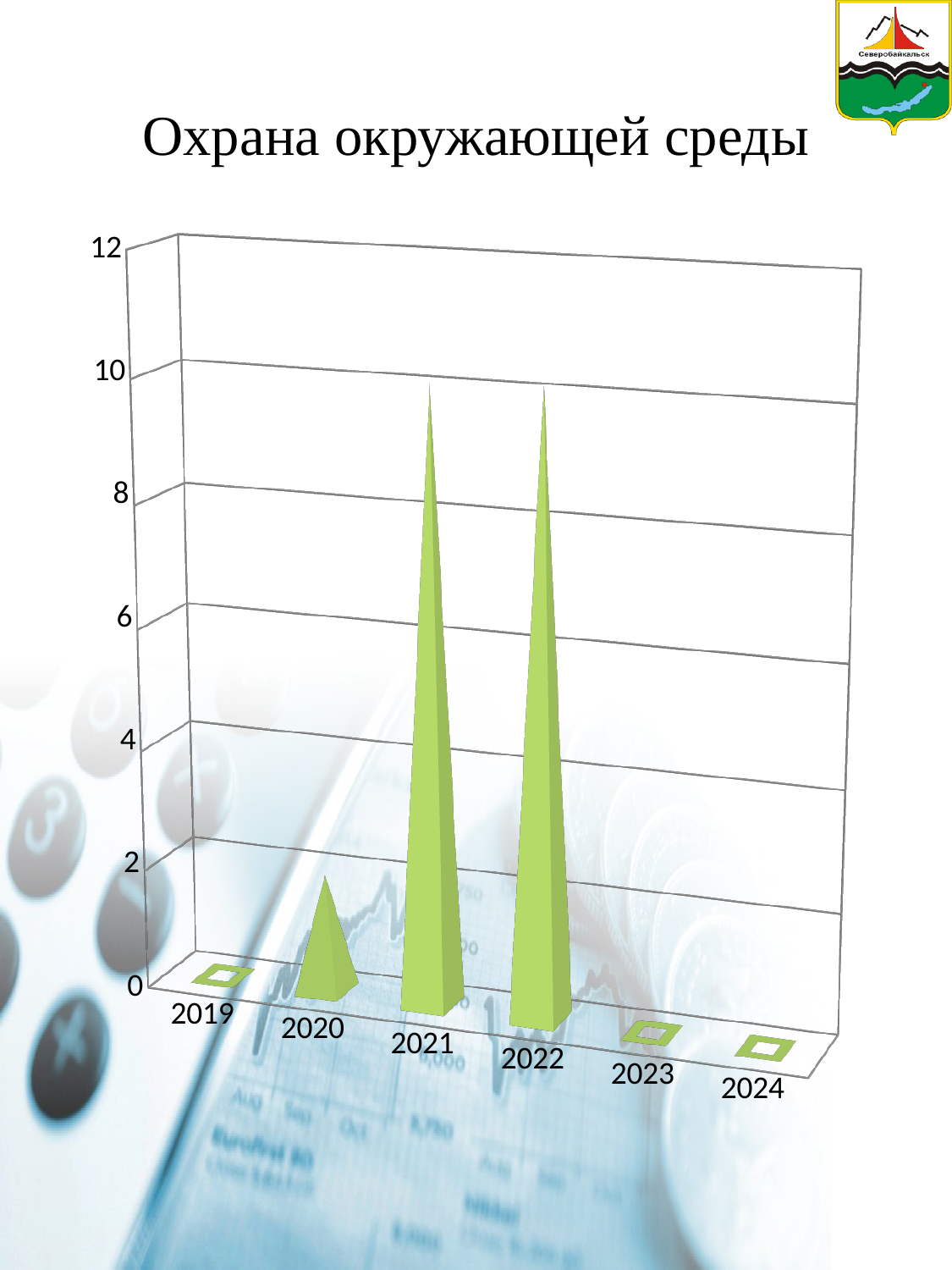
How many years are shown on the x axis of the chart? 6 Which year has the larger value, 2022 or 2023? 2022 Do the values rise or fall from 2022 to 2024? fall What colour are the bars in the chart? green Is the value for 2022 greater or less than 8? greater What is the value for 2024? 0 Which year has the larger value, 2020 or 2021? 2021 Is the value for 2021 greater or less than 6? greater Is the value for 2021 greater or less than 12? less What is the title of the chart on the slide? Охрана окружающей среды What kind of chart is shown on the slide? bar chart